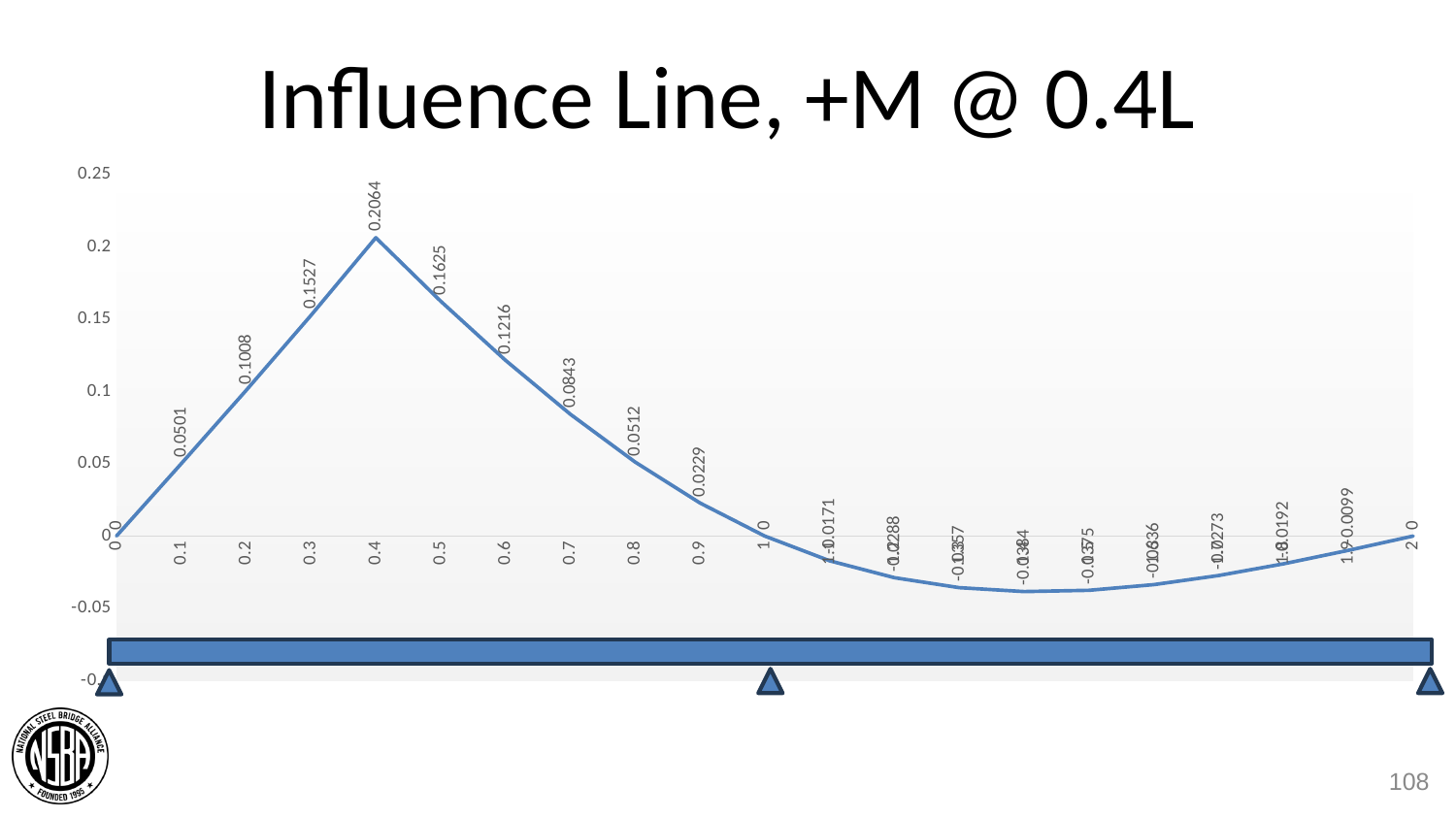
Is the value of the influence line at x = 1.4 greater or less than 0? less Does the influence line rise or fall between x = 0.4 and x = 1.0? fall What kind of chart is shown on the slide? line chart How many data points are plotted along the x axis from 0 to 2? 21 What is the value of the influence line at x = 0.7? 0.0843 What is the value of the influence line at x = 0.9? 0.0229 Which is larger, the value at x = 0.3 or the value at x = 0.6? 0.3 What is the difference between the values at x = 0.4 and x = 0.5? 0.0439 What is the title of the chart? Influence Line, +M @ 0.4L At which x position does the influence line reach its highest value? 0.4 What is the value of the influence line at x = 0.4? 0.2064 What is the value of the influence line at x = 0.2? 0.1008